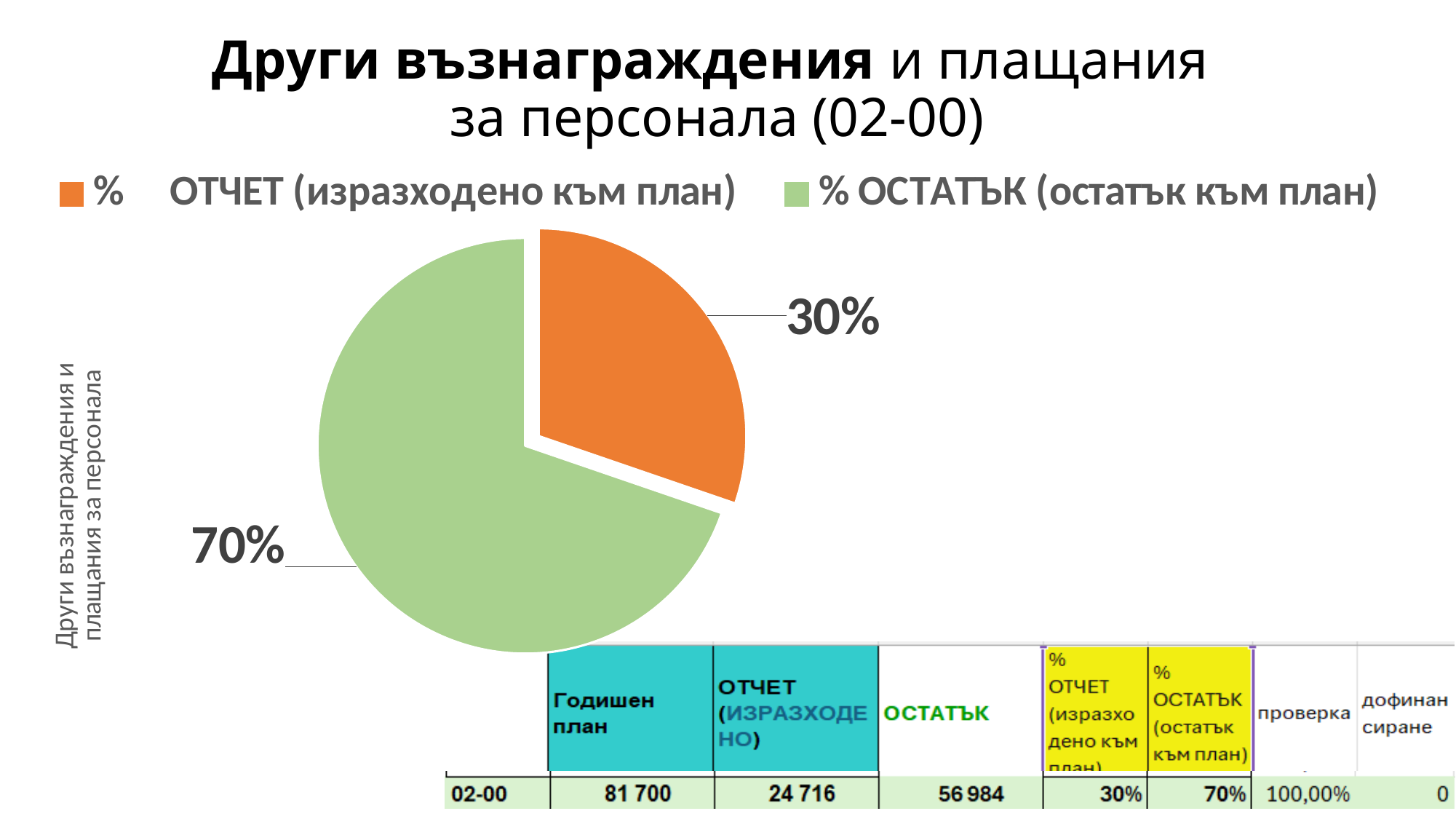
What kind of chart is shown on the slide? pie chart How many slices does the pie chart have? 2 What is the difference in percentage points between the "% ОСТАТЪК" slice and the "% ОТЧЕТ" slice? 40 percentage points Which is larger: the "% ОТЧЕТ" slice or the "% ОСТАТЪК" slice? % ОСТАТЪК What is the total of the two pie slices shown? 100% How many entries does the legend list? 2 Which slice of the pie is the largest? % ОСТАТЪК (остатък към план) Which slice of the pie is the smallest? % ОТЧЕТ (изразходено към план) What colour is the "% ОСТАТЪК (остатък към план)" slice? green What colour is the "% ОТЧЕТ (изразходено към план)" slice? orange What share of the pie does the "% ОСТАТЪК (остатък към план)" slice represent? 70% What share of the pie does the "% ОТЧЕТ (изразходено към план)" slice represent? 30%